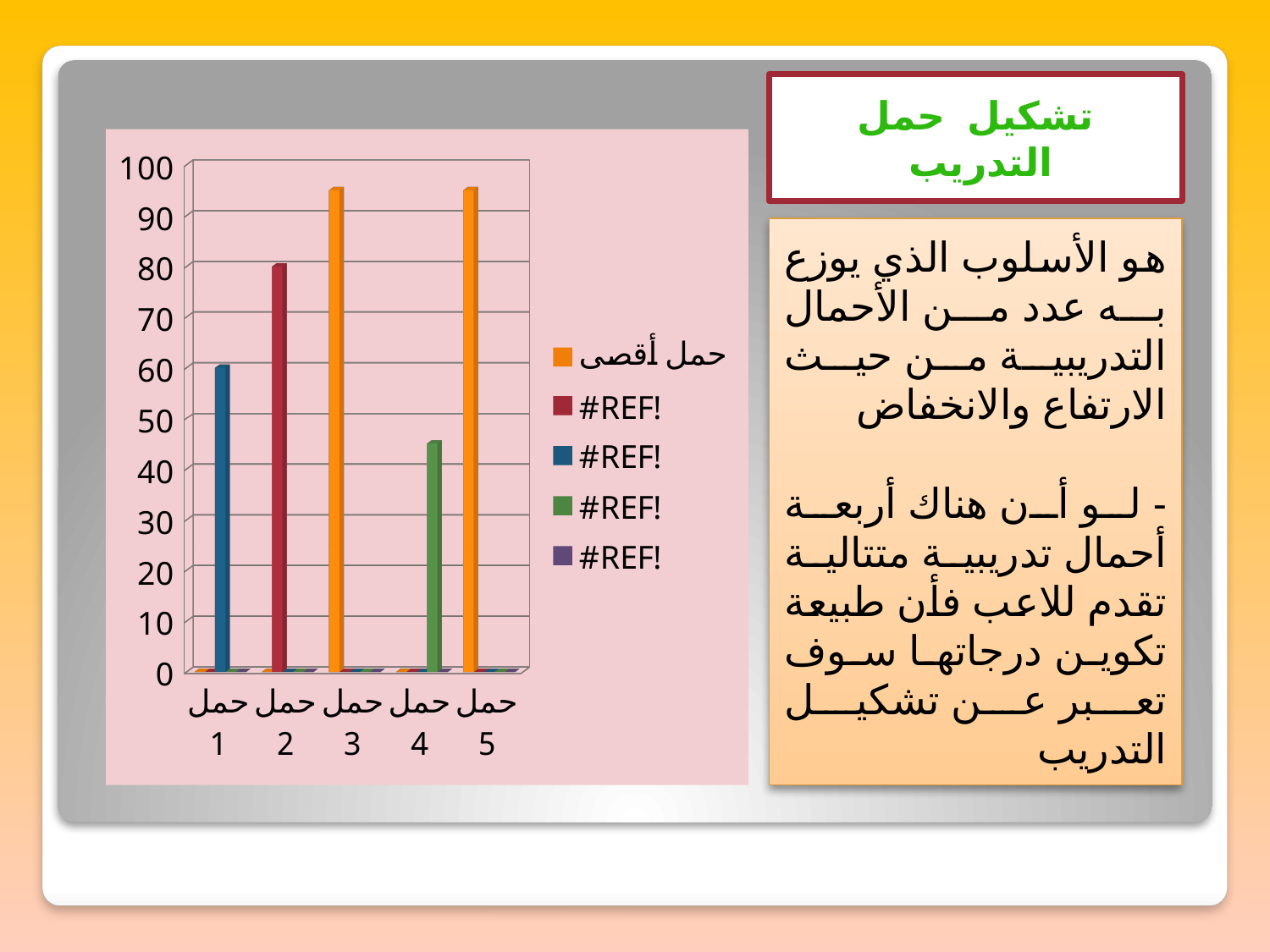
How many series does the chart's legend list? 5 How many categories are shown on the x axis of the chart? 5 Is the value for حمل 1 greater or less than 50? greater Is the value for حمل 2 greater or less than 70? greater Which is larger, the value for حمل 1 or the value for حمل 3? حمل 3 Is the value for حمل 3 greater or less than 90? greater Which is larger, the value for حمل 2 or the value for حمل 4? حمل 2 Which category has the lowest bar in the chart? حمل 4 What is the first entry in the chart's legend? حمل أقصى What kind of chart is shown on the slide? bar chart